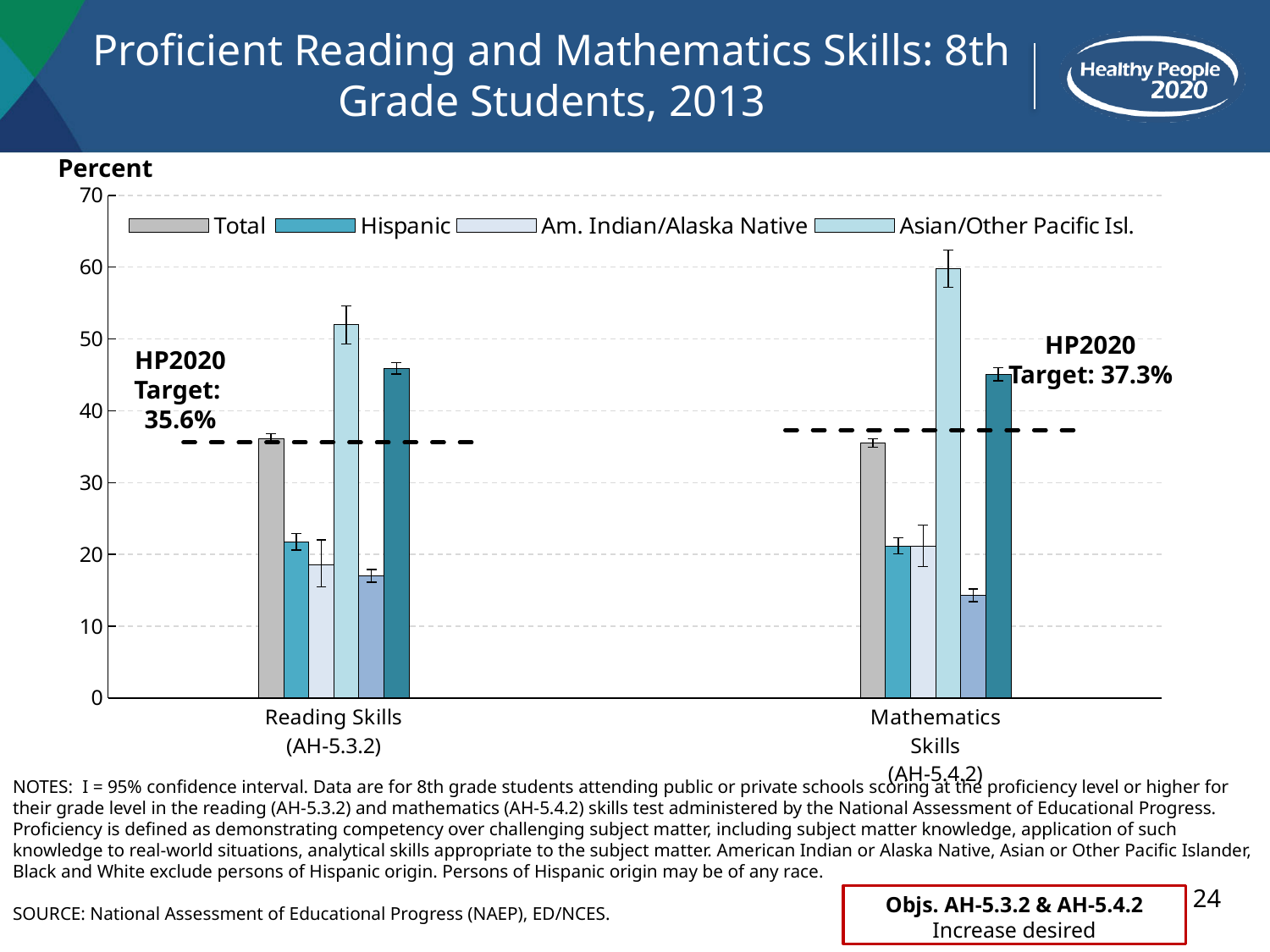
How many skill categories are shown along the x axis? 2 How much higher is the HP2020 target for Mathematics Skills than the target for Reading Skills? 1.7 percentage points What label is shown on the vertical axis of the chart? Percent What is the HP2020 target shown for Reading Skills? 35.6% How many series does the chart legend list? 4 Is the value for Asian/Other Pacific Isl. in Reading Skills greater or less than 50? greater Which legend group has the highest bar in the Reading Skills category? Asian/Other Pacific Isl. Is the value for Hispanic in Reading Skills greater or less than 30? less What kind of chart is shown on the slide? bar chart Is the value for Asian/Other Pacific Isl. in Mathematics Skills greater or less than 50? greater Is the Asian/Other Pacific Isl. value larger for Reading Skills or for Mathematics Skills? Mathematics Skills What is the HP2020 target shown for Mathematics Skills? 37.3%